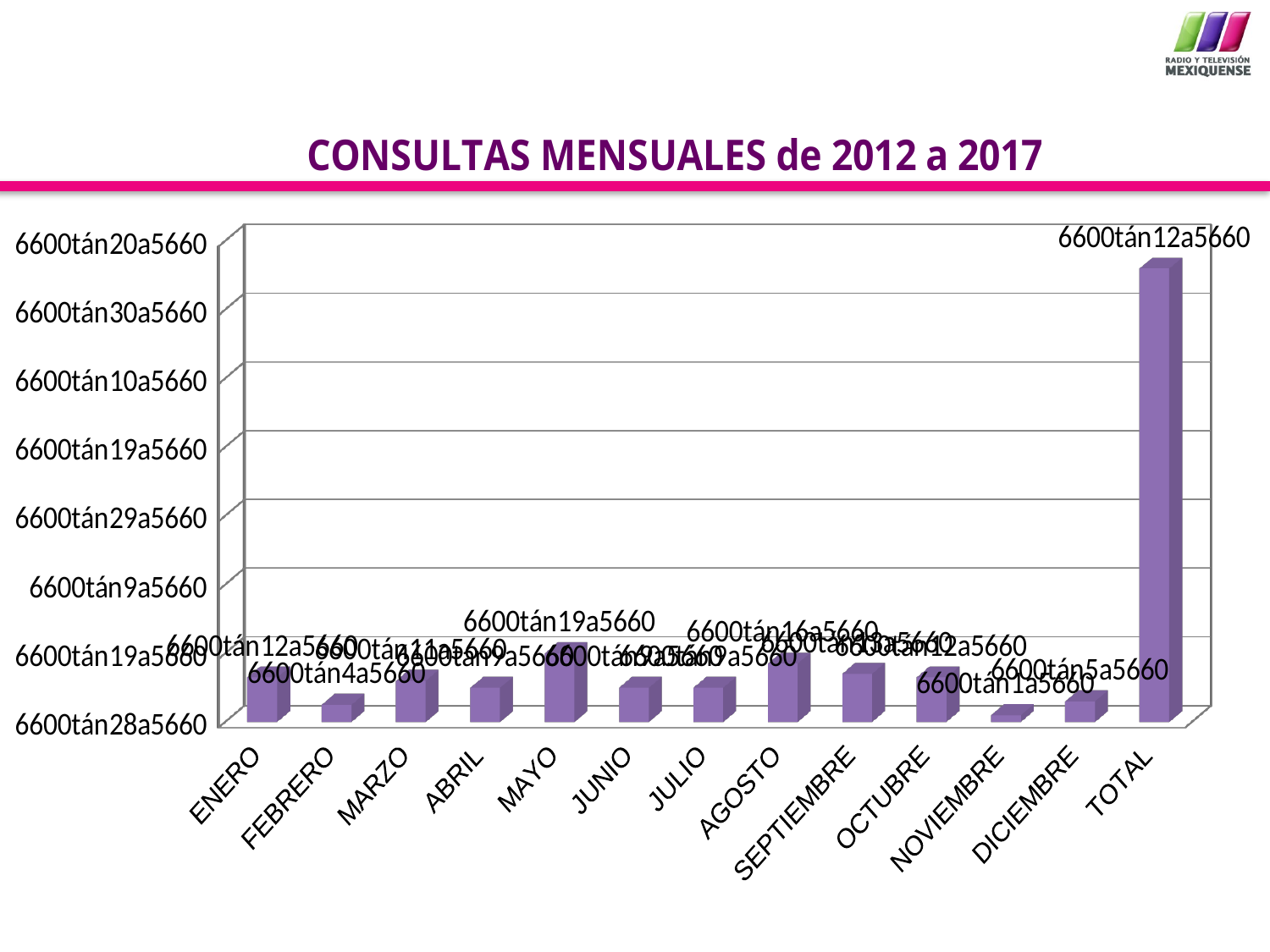
What kind of chart is shown on the slide? bar chart How many categories are shown on the x axis of the chart? 13 Which bar is taller, MAYO or FEBRERO? MAYO Excluding TOTAL, which month has the tallest bar? MAYO Which bar is taller, TOTAL or MAYO? TOTAL Which bar is taller, AGOSTO or JUNIO? AGOSTO Which category has the shortest bar in the chart? NOVIEMBRE Which is the first category on the x axis of the chart? ENERO What colour are the bars in the chart? purple Which category has the tallest bar in the chart? TOTAL What is the title of the chart? CONSULTAS MENSUALES de 2012 a 2017